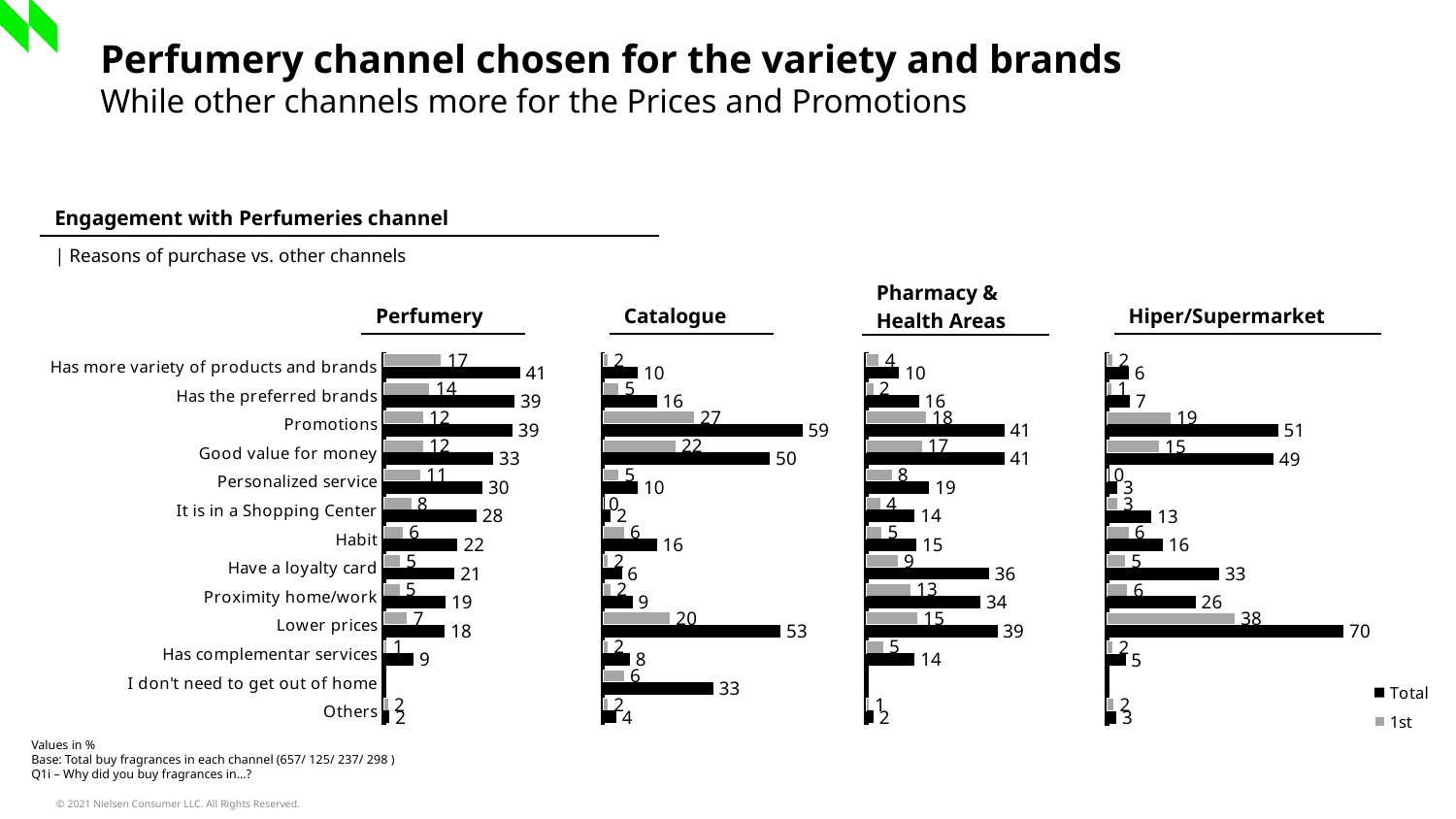
In the Catalogue chart, what is the Total value for 'Lower prices'? 53 In the Perfumery chart, which reason has the lowest Total value? Others In the Catalogue chart, which reason has the highest Total value? Promotions In the Catalogue chart, what is the difference between the Total values for Promotions and Lower prices? 6 In the Perfumery chart, what is the Total value for 'Has more variety of products and brands'? 41 In the Pharmacy & Health Areas chart, which is larger: the Total value for 'Proximity home/work' or for 'Habit'? Proximity home/work In the Hiper/Supermarket chart, what is the 1st value for 'Lower prices'? 38 What kind of chart is used for the Perfumery data? Bar chart In the Hiper/Supermarket chart, which reason has the highest Total value? Lower prices In the Hiper/Supermarket chart, what is the difference between the Total and 1st values for Promotions? 32 How many series does the legend list? 2 In the Pharmacy & Health Areas chart, what is the Total value for 'Have a loyalty card'? 36